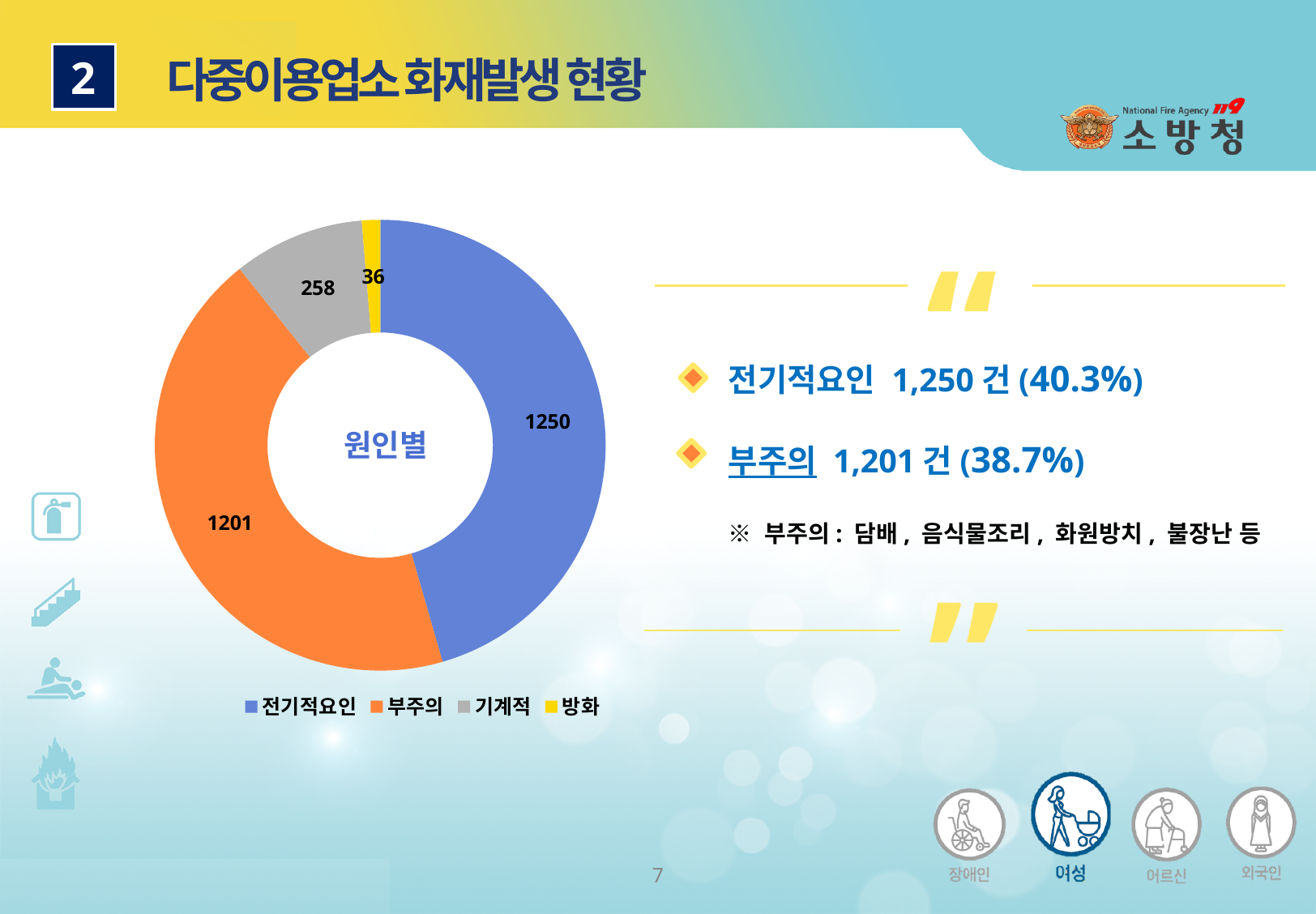
What is the difference between the values for 전기적요인 and 부주의? 49 What is the difference between the values for 기계적 and 방화? 222 What is the value for 부주의 in the pie chart? 1201 What label is shown in the centre of the donut chart? 원인별 Which category has the largest slice in the pie chart? 전기적요인 Which category has the smallest slice in the pie chart? 방화 What is the value for 기계적 in the pie chart? 258 What is the value for 방화 in the pie chart? 36 What kind of chart is shown on the slide? pie chart (donut) What is the value for 전기적요인 in the pie chart? 1250 Which is larger, the value for 기계적 or the value for 방화? 기계적 How many categories are shown in the pie chart? 4